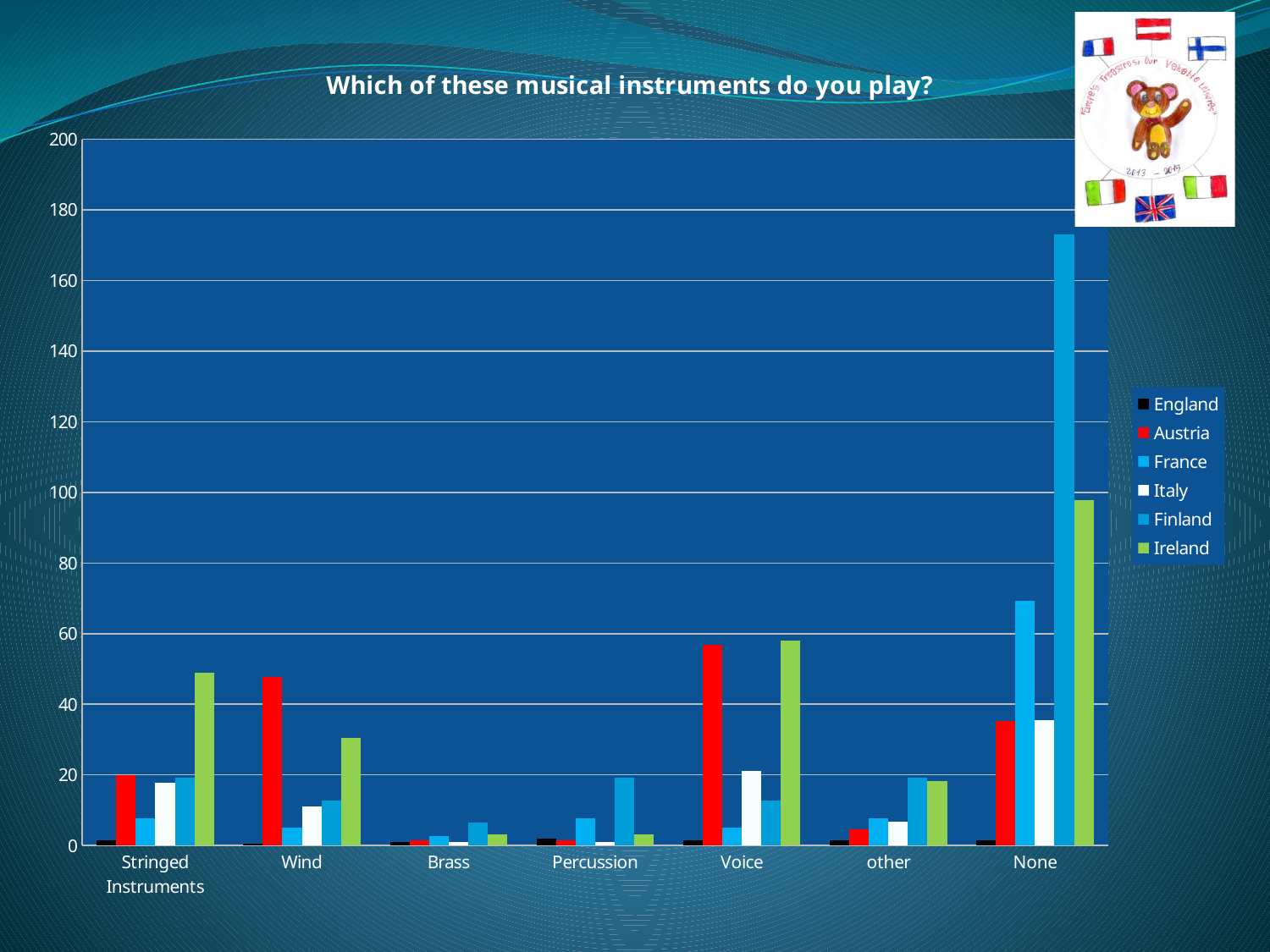
What kind of chart is shown on the slide? bar chart How many categories are shown on the x axis? 7 Is the value for Finland in the None category greater or less than 160? greater For which category is the Austria bar highest? Voice Is the value for Ireland in the None category greater or less than 80? greater In the Wind category, which is larger: Austria or Ireland? Austria What is the title of the chart? Which of these musical instruments do you play? Is the value for Finland in the Percussion category greater or less than 40? less In the Stringed Instruments category, which is larger: Ireland or Austria? Ireland For which category is the Finland bar highest? None How many series does the legend list? 6